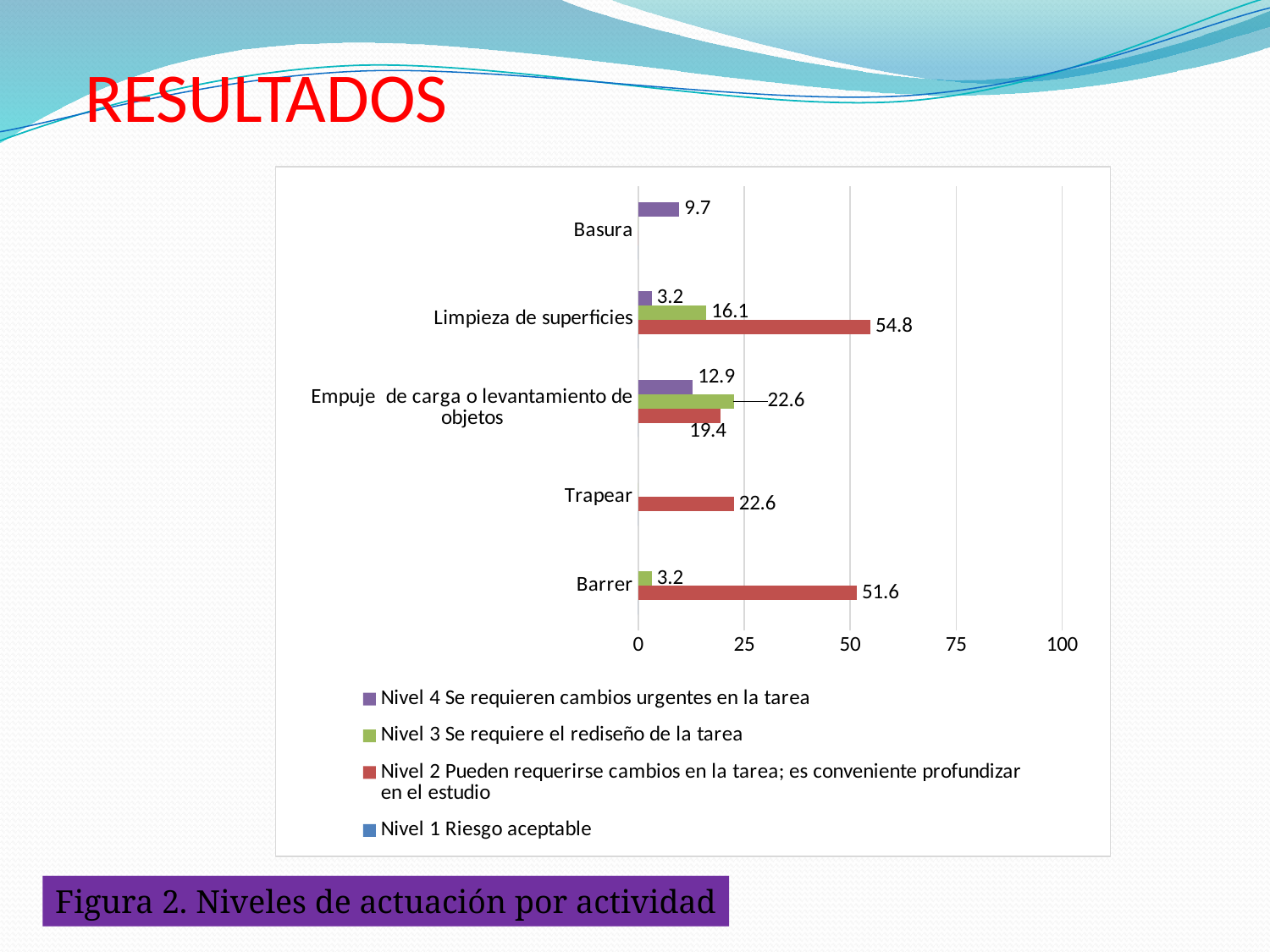
What is the Nivel 3 value for Empuje de carga o levantamiento de objetos? 22.6 Which activity has the highest Nivel 2 value? Limpieza de superficies What is the Nivel 4 value for Basura? 9.7 What is the Nivel 2 value for Trapear? 22.6 Which activity has the highest Nivel 4 value? Empuje de carga o levantamiento de objetos What kind of chart is shown on the slide? Bar chart What is the difference between the Nivel 2 values for Limpieza de superficies and Barrer? 3.2 Is the Nivel 2 value for Barrer greater or less than 50? greater Which is larger for Empuje de carga o levantamiento de objetos: the Nivel 3 value or the Nivel 2 value? Nivel 3 How many activities are shown on the chart? 5 How many series does the legend list? 4 What is the Nivel 2 value for Limpieza de superficies? 54.8